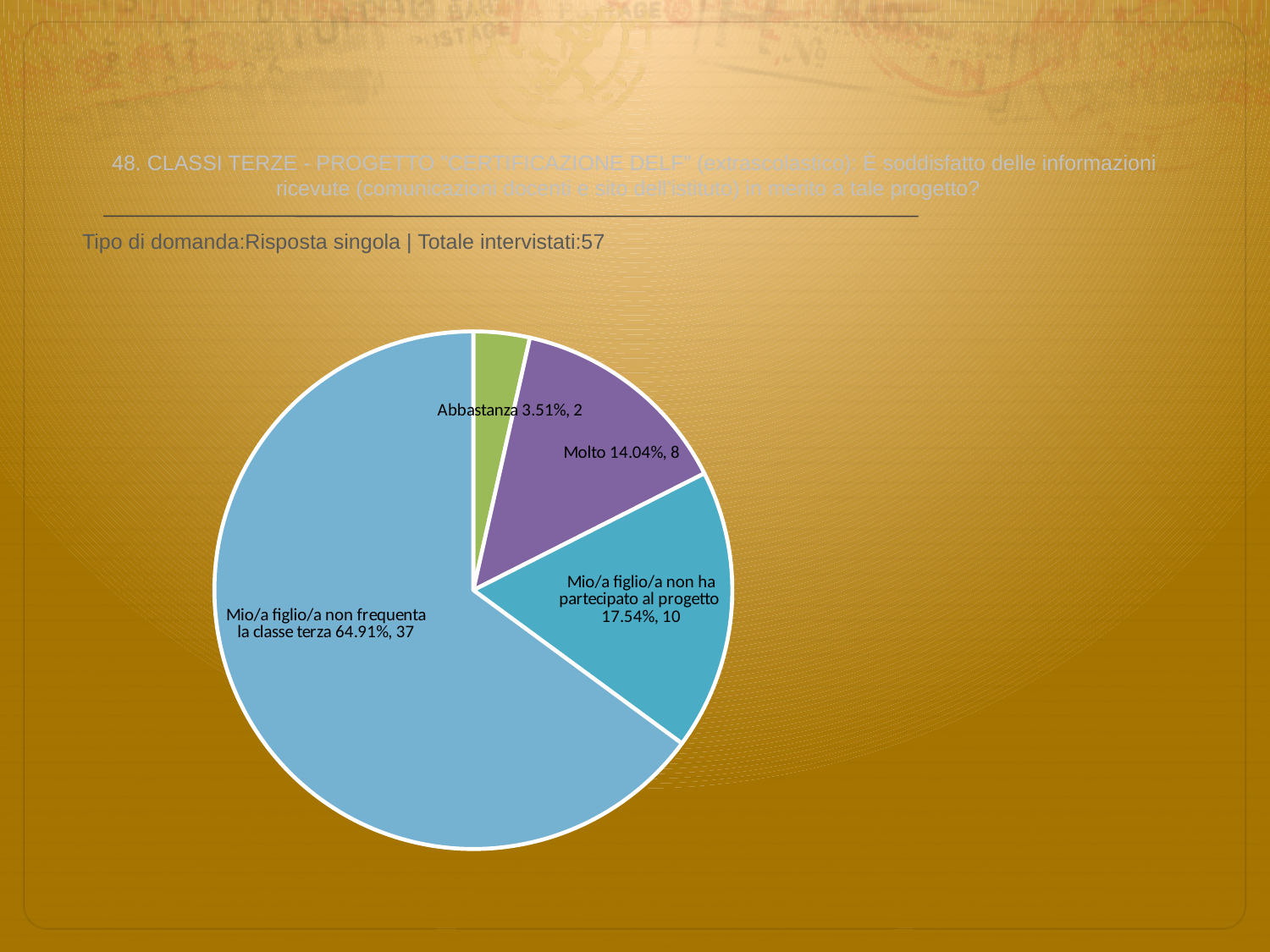
What kind of chart is shown on the slide? Pie chart What is the total number of respondents across all slices of the pie? 57 Which category has the smallest slice of the pie? Abbastanza What colour is the "Molto" slice? Purple How many respondents answered "Abbastanza"? 2 How many slices does the pie chart have? 4 What percentage share does the "Mio/a figlio/a non ha partecipato al progetto" slice have? 17.54% What is the difference in number of respondents between "Mio/a figlio/a non ha partecipato al progetto" and "Molto"? 2 What percentage share does the "Molto" slice have? 14.04% Which has more respondents, "Molto" or "Abbastanza"? Molto Which category has the largest slice of the pie? Mio/a figlio/a non frequenta la classe terza How many respondents answered "Mio/a figlio/a non frequenta la classe terza"? 37